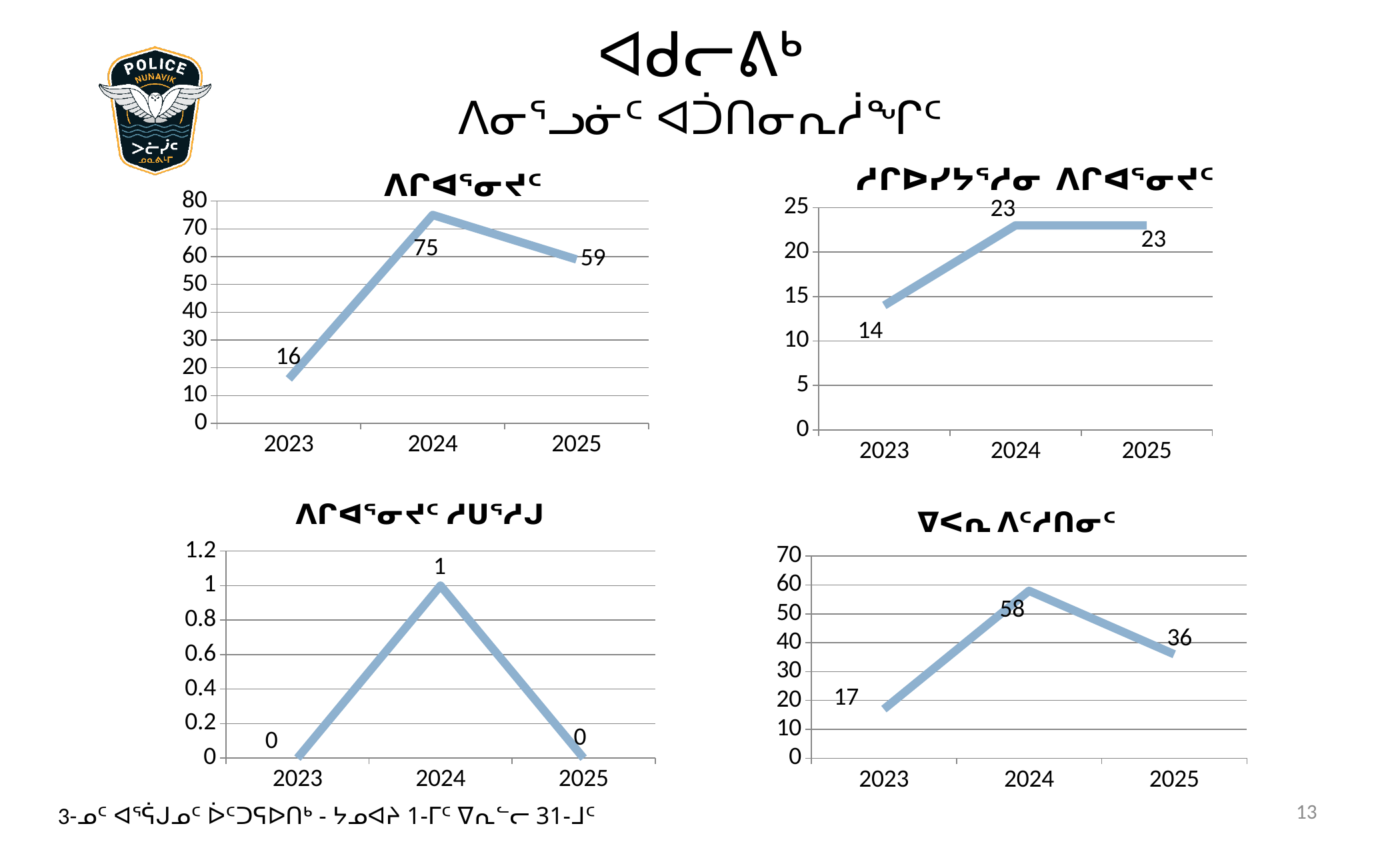
In the bottom-right chart, what is the value for 2025? 36 In the bottom-left chart, which year has the highest value? 2024 In the bottom-left chart, what is the value for 2024? 1 In the top-right chart, what is the value for 2025? 23 In the top-right chart, what is the value for 2023? 14 In the top-left chart, which year has the lowest value? 2023 In the bottom-right chart, which is larger, the value for 2023 or the value for 2025? 2025 In the top-left chart, what is the difference between the 2024 and 2025 values? 16 In the bottom-right chart, what is the difference between the 2024 and 2023 values? 41 What type of chart is the top-left chart? Line chart In the top-right chart, how many data points are plotted? 3 In the top-left chart, what is the value for 2024? 75